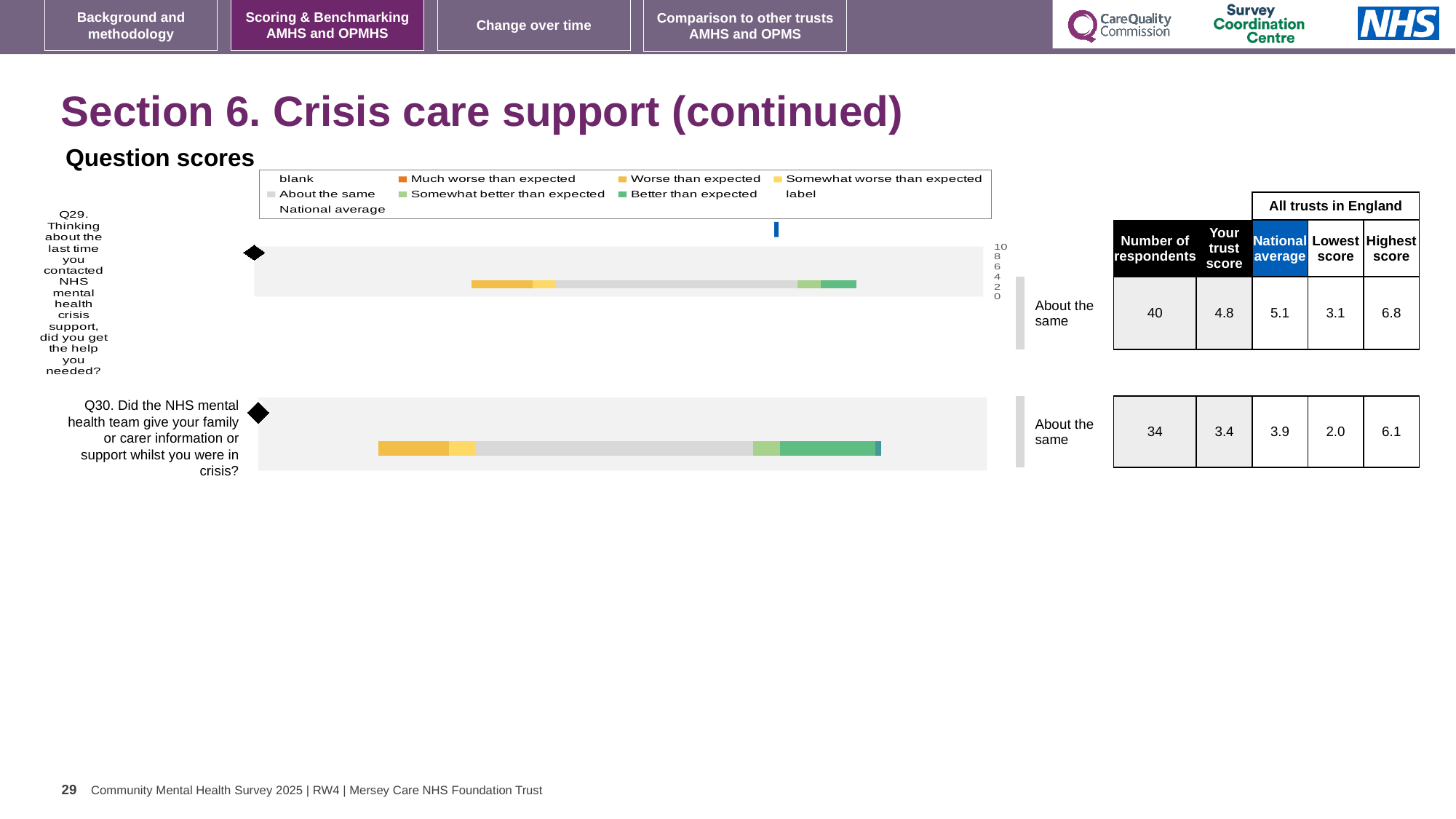
What is the difference between the national average and the trust score for Q30? 0.5 What benchmark category is shown next to the bar for Q29? About the same What kind of chart is used to show the question scores for Q29 and Q30? Bar chart For Q29, which is larger: the trust score or the national average? National average What is the national average score for Q30? 3.9 What colour does the legend use for 'About the same'? Grey How many respondents answered Q30? 34 How many questions (bars) are plotted on the slide? 2 Which question has the higher 'Highest score' across all trusts in England, Q29 or Q30? Q29 What benchmark category is shown next to the bar for Q30? About the same What colour does the legend use for 'Better than expected'? Green What is the 'Your trust score' value for Q29? 4.8